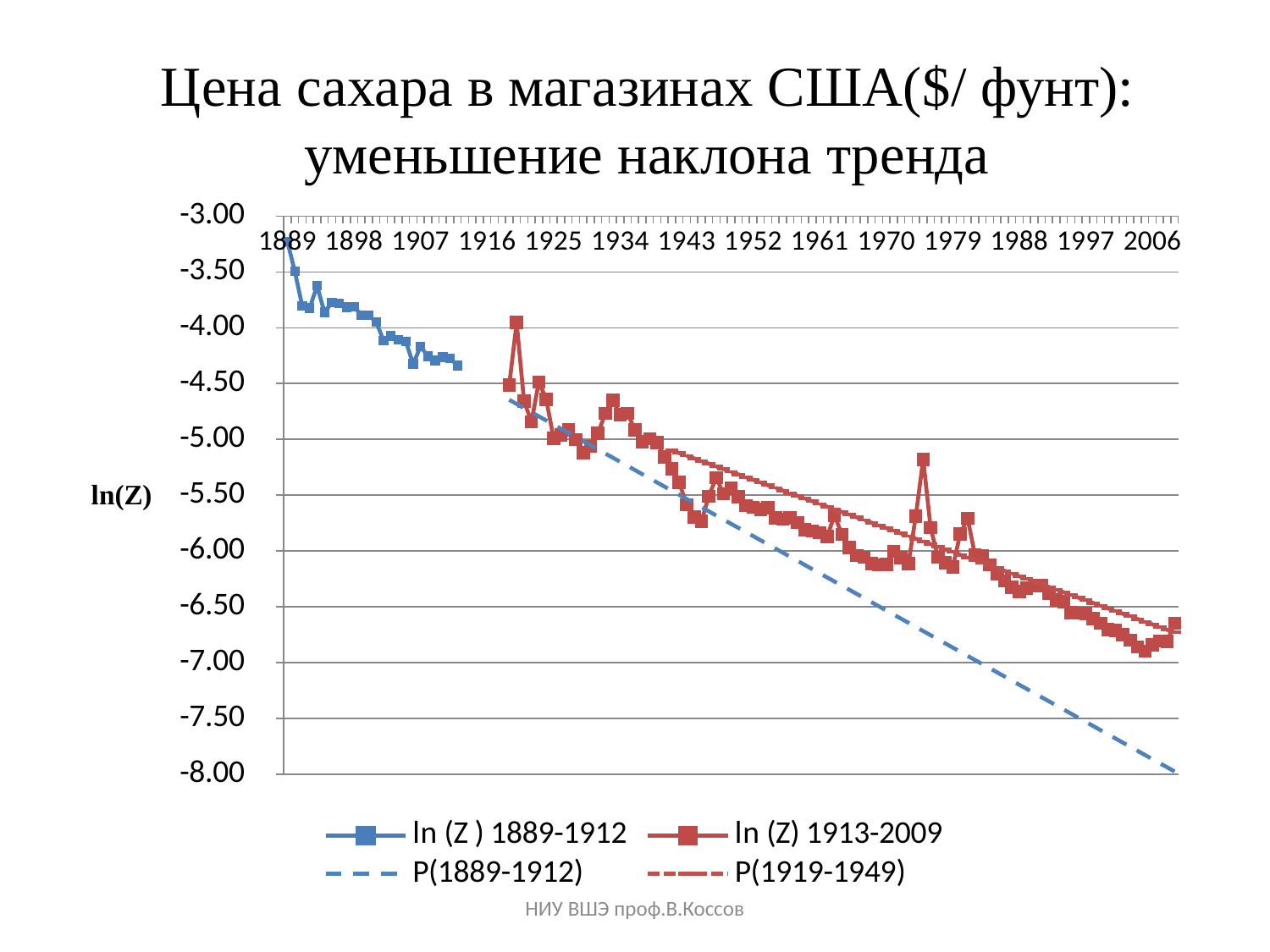
Which is larger: the value of the ln (Z ) 1889-1912 series at 1889 or the value of the ln (Z) 1913-2009 series at 2006? ln (Z ) 1889-1912 at 1889 Is the highest point of the ln (Z) 1913-2009 series greater or less than -4.50? greater Is the value of the ln (Z) 1913-2009 series at 2006 greater or less than -6.50? less How many year labels are shown on the x axis? 14 Is the value of the ln (Z ) 1889-1912 series at 1889 greater or less than -3.50? greater What is the title of the chart? Цена сахара в магазинах США($/ фунт): уменьшение наклона тренда What is the label on the vertical axis? ln(Z) How many series does the legend list? 4 What is the lowest value shown on the vertical axis? -8.00 What kind of chart is shown on the slide? line chart Do the values of the ln (Z) 1913-2009 series generally rise or fall along the x axis? fall